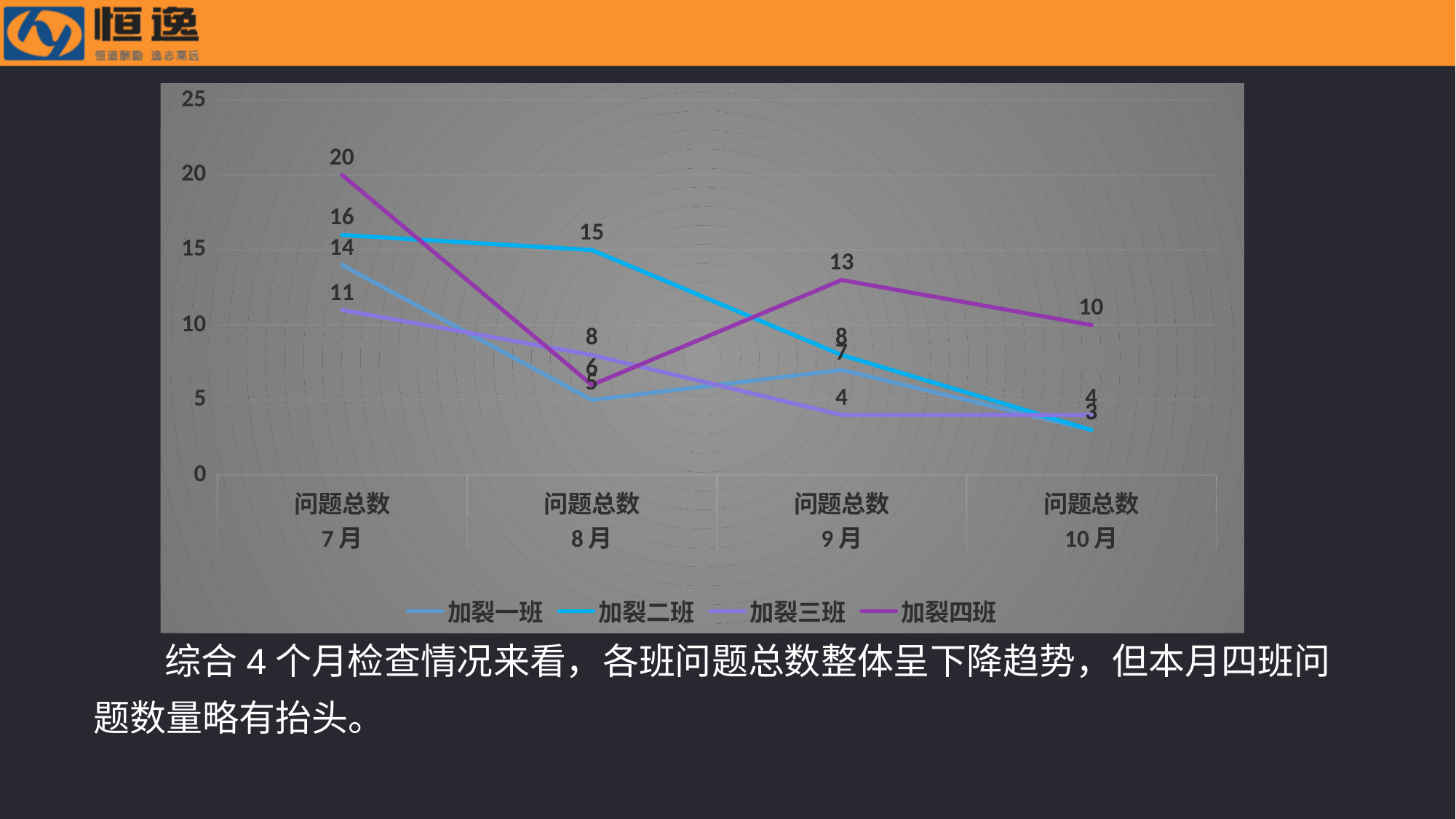
What is the value for 加裂一班 in 7月? 14 What is the value for 加裂三班 in 9月? 4 How many months are shown on the x axis? 4 In 9月, which is larger: 加裂四班 or 加裂二班? 加裂四班 What is the difference between the 加裂四班 values in 7月 and 8月? 14 In which month does 加裂四班 reach its highest value? 7月 What is the value for 加裂二班 in 8月? 15 What kind of chart is shown on the slide? line chart Which series has the highest value in 7月? 加裂四班 Which series has the lowest value in 10月? 加裂一班 and 加裂二班 (tie at 3) What is the value for 加裂四班 in 7月? 20 How many series does the legend list? 4